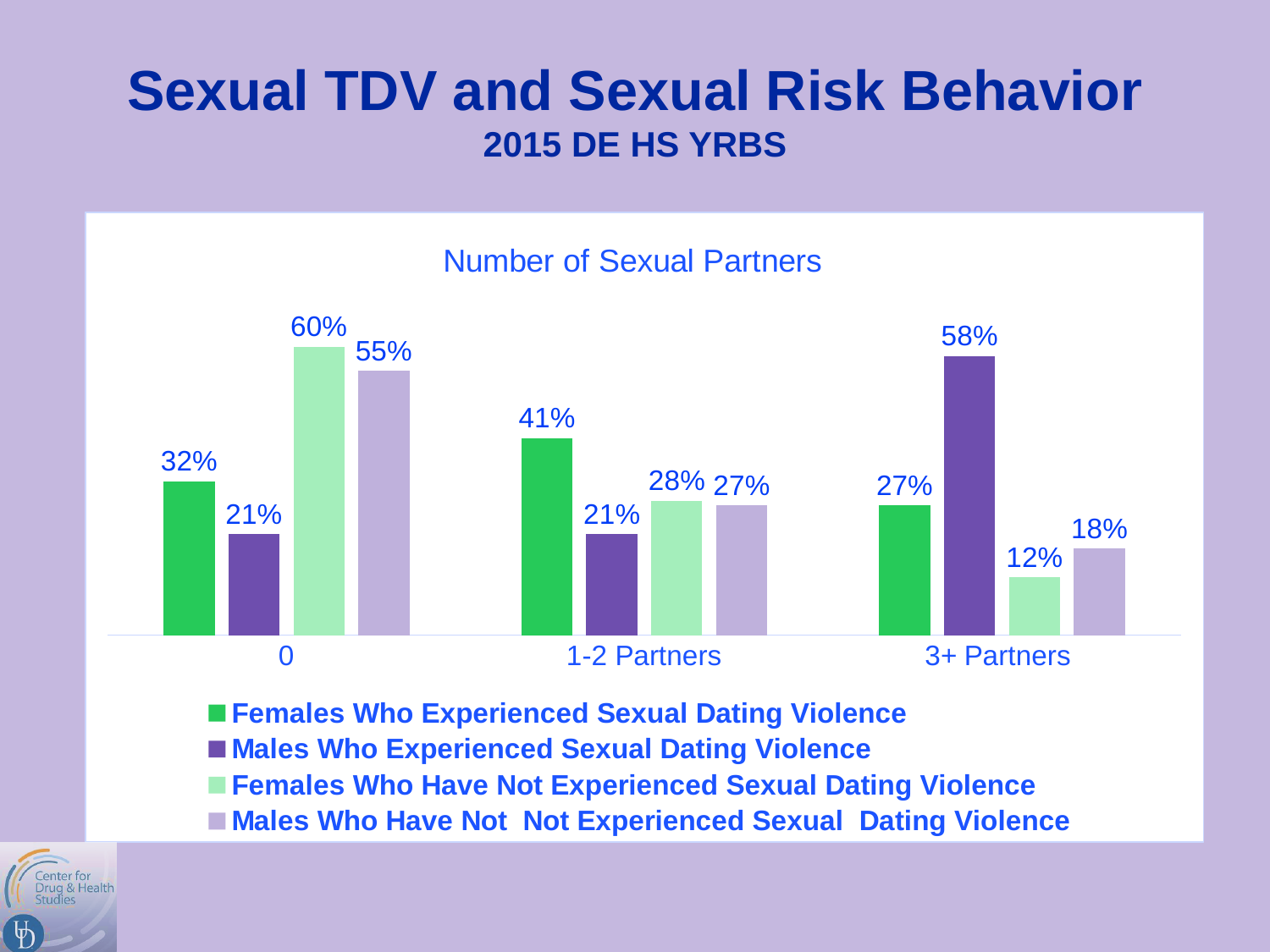
In the 3+ Partners category, which is larger: Males Who Experienced Sexual Dating Violence or Females Who Experienced Sexual Dating Violence? Males Who Experienced Sexual Dating Violence Which category has the lowest value for Males Who Have Not Experienced Sexual Dating Violence? 3+ Partners What is the title of the chart? Number of Sexual Partners What is the value for Females Who Have Not Experienced Sexual Dating Violence in the 1-2 Partners category? 28% How many series does the legend list? 4 What kind of chart is shown on the slide? Bar chart What is the value for Females Who Experienced Sexual Dating Violence in the 0 partners category? 32% Do the values for Females Who Have Not Experienced Sexual Dating Violence rise or fall from 0 to 3+ Partners? Fall Which category has the highest value for Females Who Have Not Experienced Sexual Dating Violence? 0 How many categories are shown on the x axis? 3 What is the difference between Females Who Experienced Sexual Dating Violence and Males Who Experienced Sexual Dating Violence in the 1-2 Partners category? 20% What is the value for Males Who Experienced Sexual Dating Violence in the 3+ Partners category? 58%